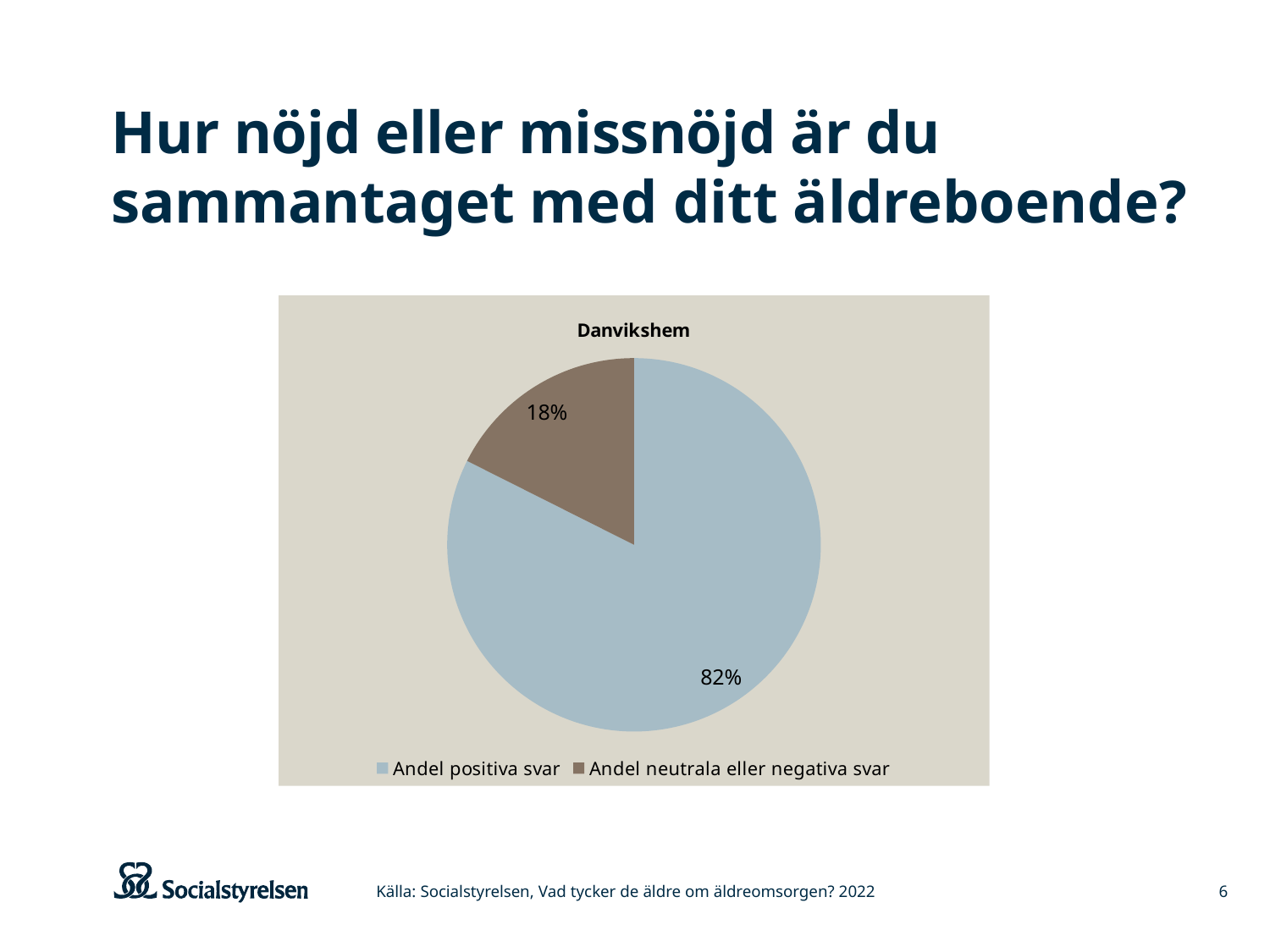
How many slices does the pie chart have? 2 How many entries does the legend list? 2 What share of the pie is 'Andel neutrala eller negativa svar'? 18% What is the title of the chart? Danvikshem What colour is the 'Andel neutrala eller negativa svar' slice? brown Which is larger: 'Andel positiva svar' or 'Andel neutrala eller negativa svar'? Andel positiva svar What share of the pie is 'Andel positiva svar'? 82% What kind of chart is shown on the slide? pie chart What is the difference between the 'Andel positiva svar' share and the 'Andel neutrala eller negativa svar' share? 64% Which slice is the largest? Andel positiva svar Which slice is the smallest? Andel neutrala eller negativa svar